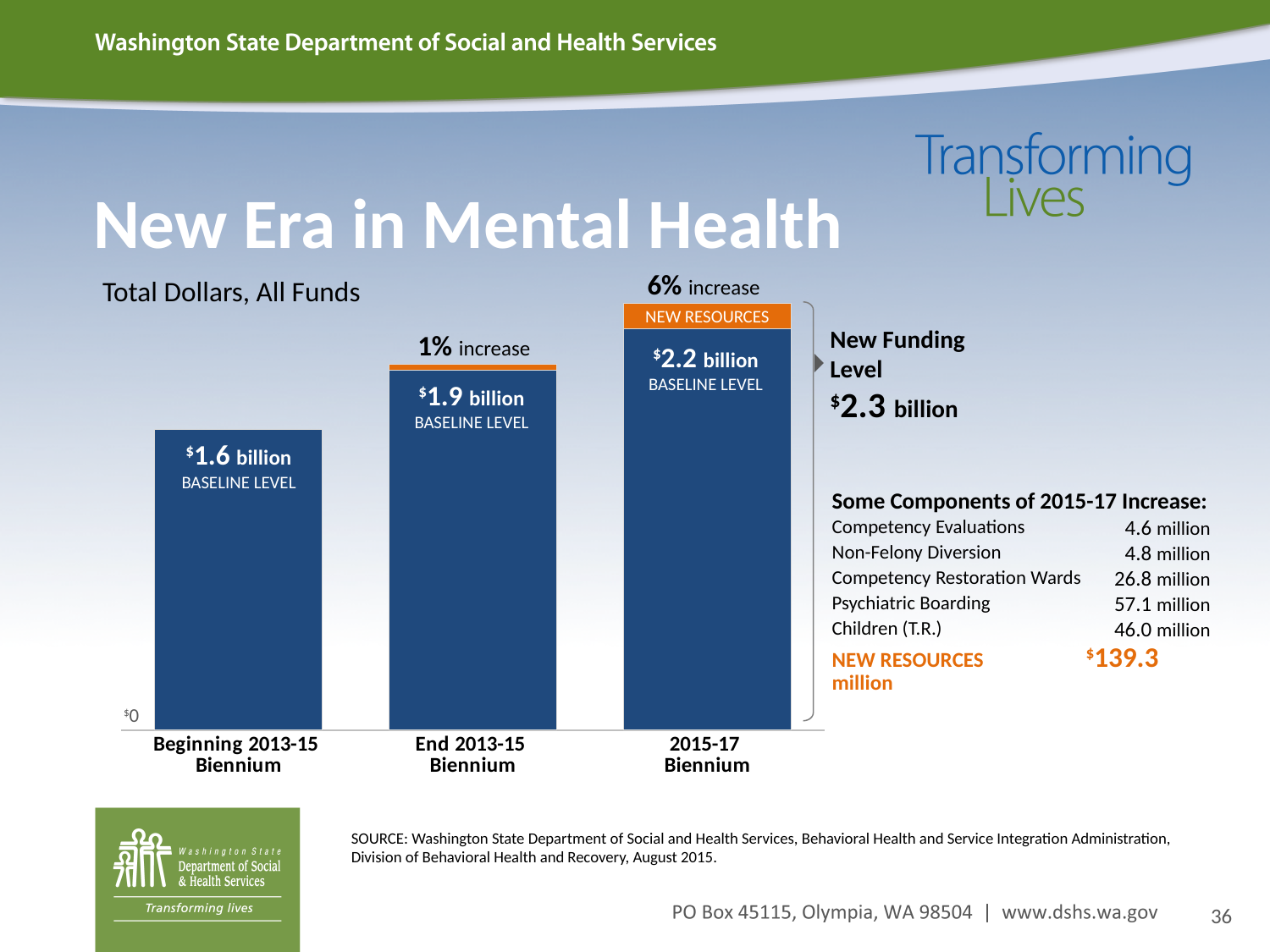
Do the baseline levels rise or fall from the Beginning 2013-15 Biennium to the 2015-17 Biennium? Rise Which biennium has the highest baseline level? 2015-17 Biennium What is the baseline level shown for the Beginning 2013-15 Biennium bar? $1.6 billion Which biennium has the lowest baseline level? Beginning 2013-15 Biennium How many bars are shown in the chart? 3 What is the baseline level shown for the End 2013-15 Biennium bar? $1.9 billion What is the baseline level shown for the 2015-17 Biennium bar? $2.2 billion What percentage increase is labeled above the End 2013-15 Biennium bar? 1% What new funding level is shown for the 2015-17 Biennium? $2.3 billion What percentage increase is labeled above the 2015-17 Biennium bar? 6% What kind of chart is shown on the slide? Bar chart What is the difference between the 2015-17 Biennium baseline level and the Beginning 2013-15 Biennium baseline level? $0.6 billion